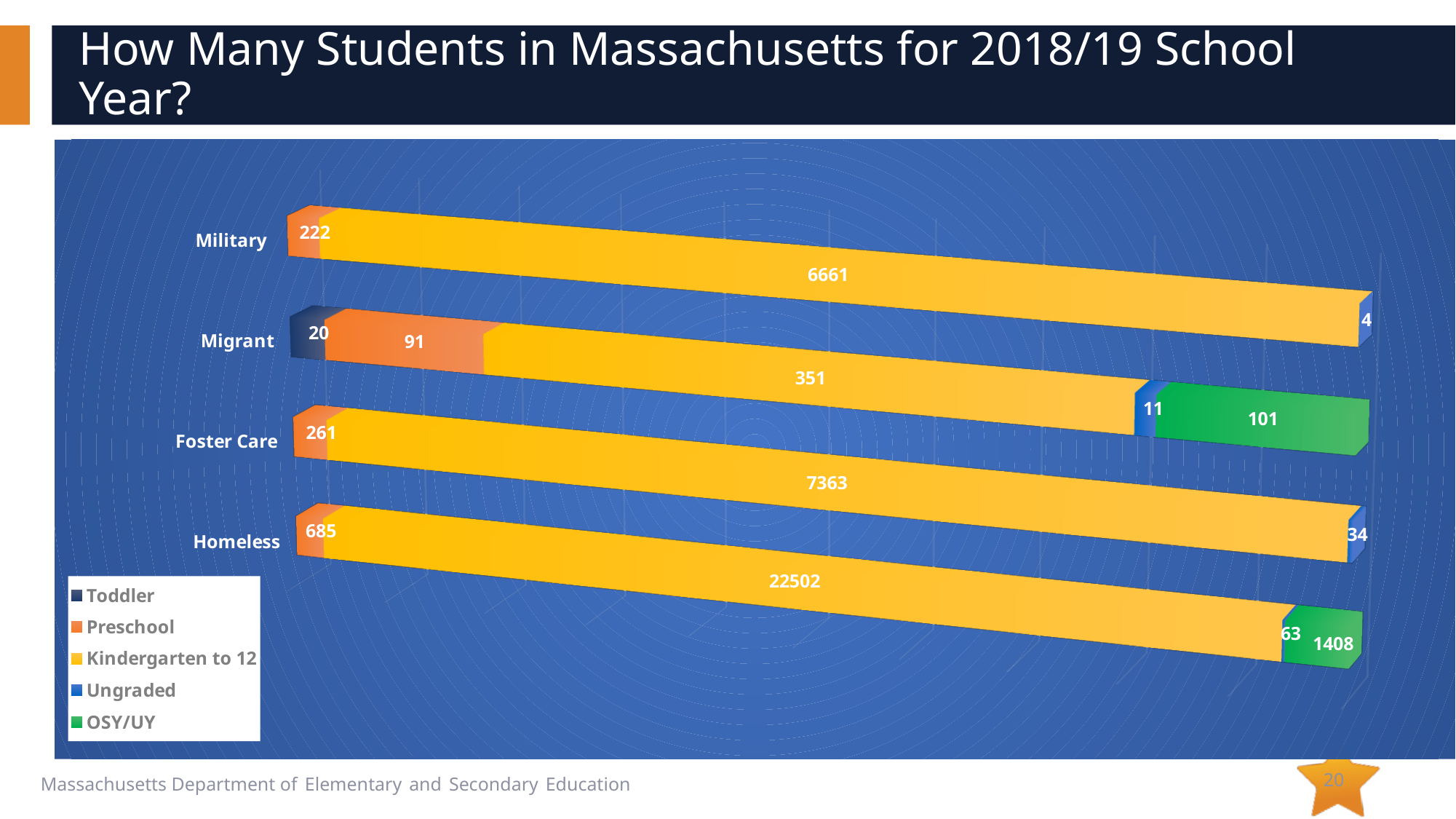
How many series does the legend list? 5 How many categories are shown on the chart? 4 What is the Toddler value for the Migrant category? 20 What is the difference between the Preschool values for Homeless and Foster Care? 424 Which category has the lowest Ungraded value? Military What is the OSY/UY value for the Migrant category? 101 How many Kindergarten to 12 students are shown for the Homeless category? 22502 What is the Preschool value for the Military category? 222 What kind of chart is shown on the slide? Stacked bar chart Which is larger, the Preschool value for Migrant or for Foster Care? Foster Care What is the total of all labelled segments in the Migrant bar? 574 Which category has the highest Kindergarten to 12 value? Homeless